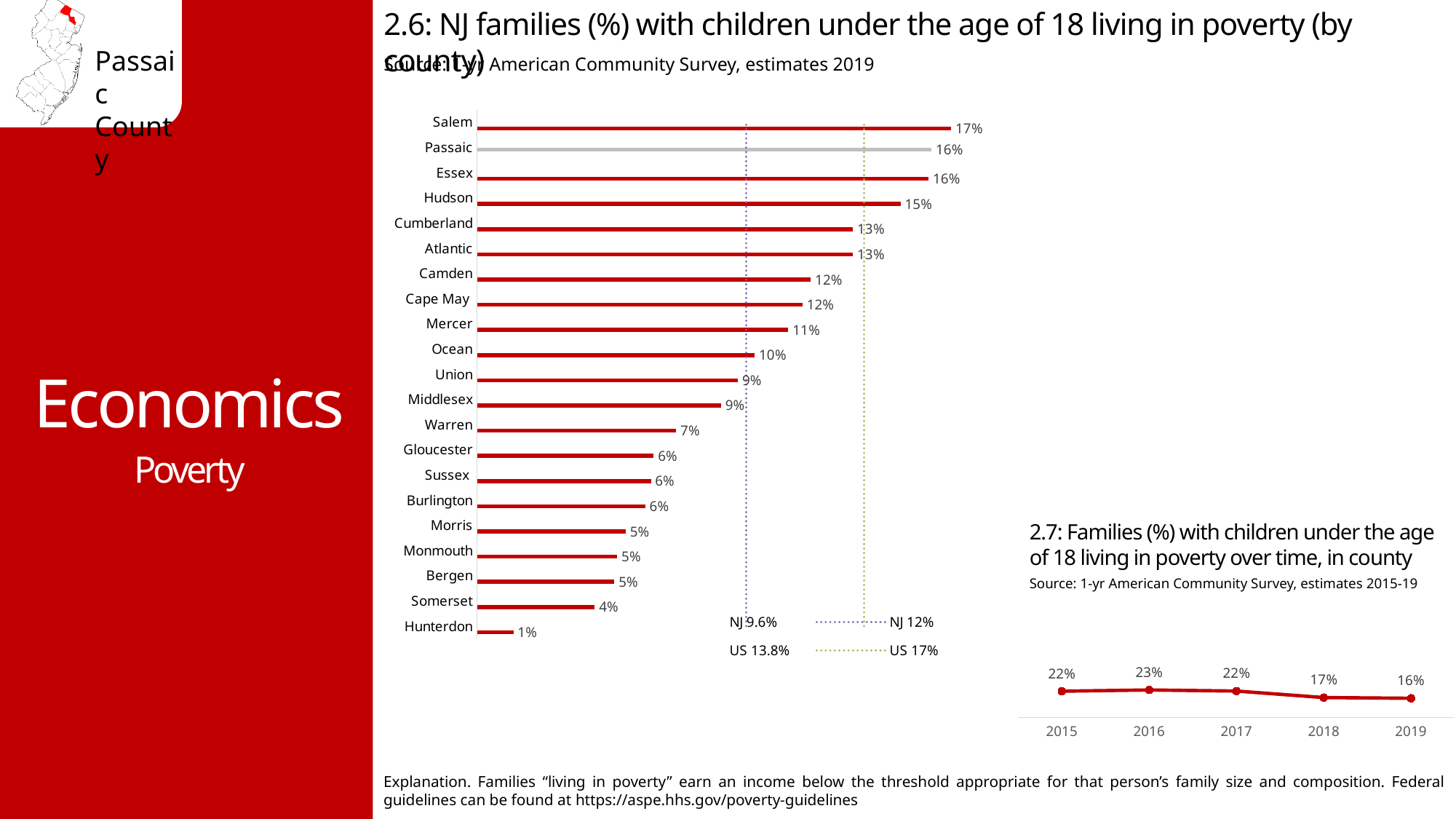
In chart 2.7 (families with children under 18 living in poverty over time), what is the value for 2016? 23% In chart 2.6, which county has the highest percentage of families with children living in poverty? Salem In chart 2.7, what is the difference between the values for 2015 and 2019? 6% In chart 2.6 (NJ families with children under 18 living in poverty by county), what is the value for Passaic? 16% In chart 2.7, do the values generally rise or fall from 2015 to 2019? Fall In chart 2.6, which county has a larger value, Mercer or Warren? Mercer In chart 2.6, what is the value for Hudson? 15% In chart 2.6, what is the difference between the values for Salem and Hunterdon? 16% In chart 2.6, how many counties are shown? 21 What kind of chart is chart 2.6? Bar chart In chart 2.6, which county has the lowest percentage of families with children living in poverty? Hunterdon